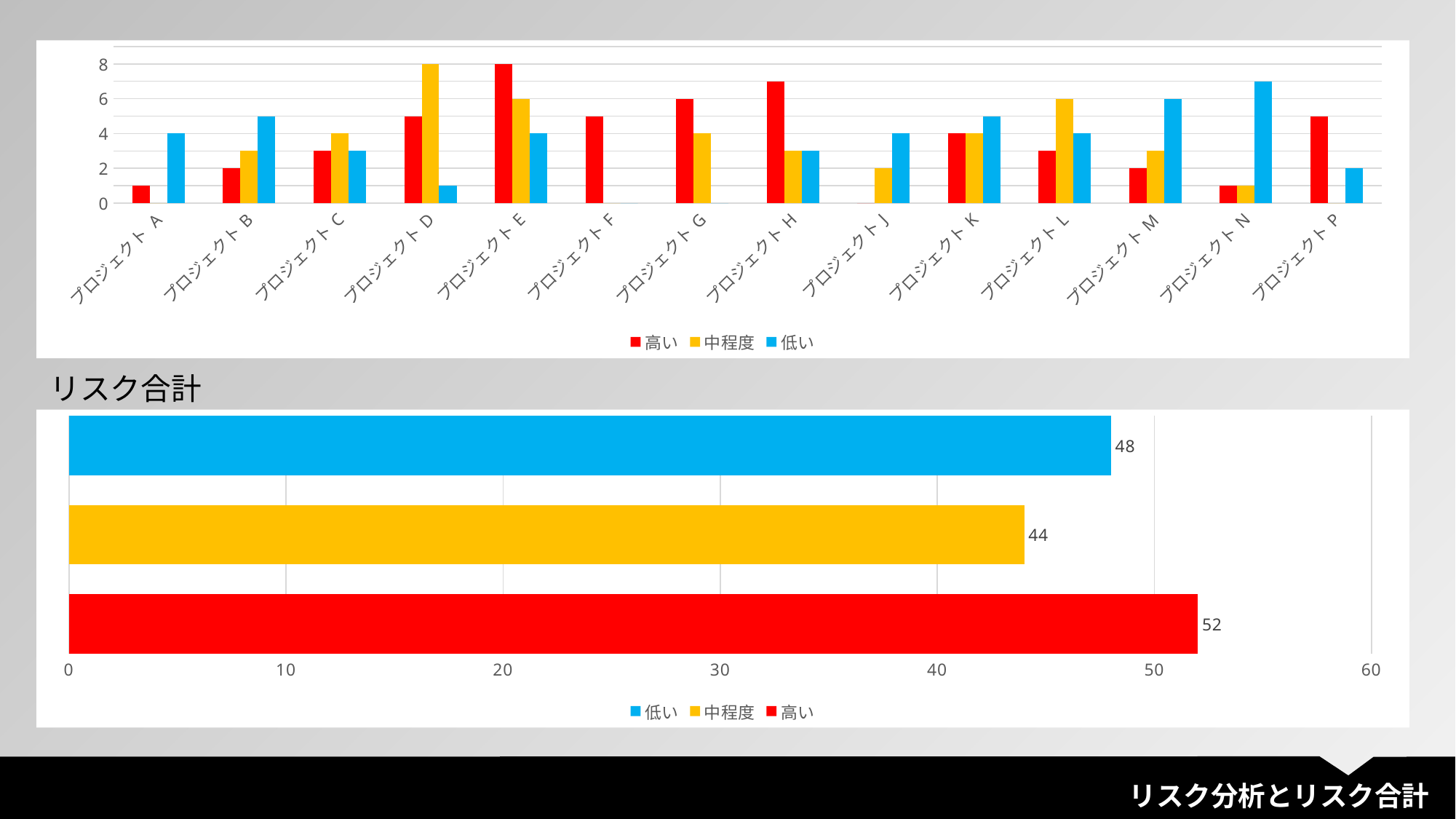
In the bottom chart titled リスク合計, what is the difference between the values for 高い and 中程度? 8 In the bottom chart titled リスク合計, what is the value for 低い? 48 In the top chart, which is larger for プロジェクト H: 高い or 低い? 高い In the top chart, how many series does the legend list? 3 In the bottom chart titled リスク合計, what kind of chart is shown? bar chart In the bottom chart titled リスク合計, what is the value for 中程度? 44 In the top chart, what is the value of 高い for プロジェクト E? 8 In the top chart, how many projects are shown on the x axis? 14 In the bottom chart titled リスク合計, what is the value for 高い? 52 In the bottom chart titled リスク合計, which category has the lowest value? 中程度 In the bottom chart titled リスク合計, which category has the highest value? 高い In the top chart, is the value of 中程度 for プロジェクト D greater or less than 6? greater